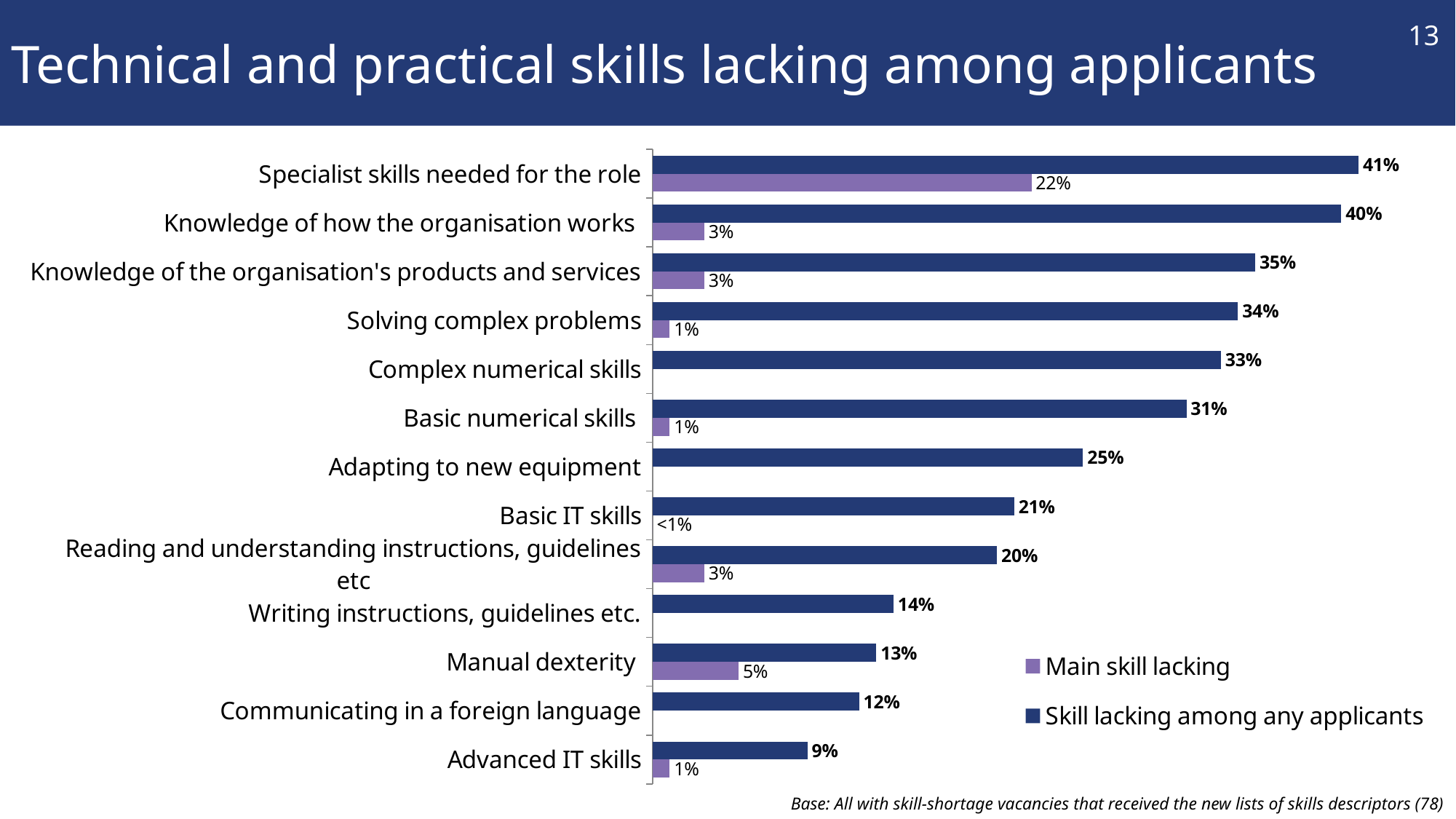
Which category has the highest 'Skill lacking among any applicants' value? Specialist skills needed for the role What is the 'Skill lacking among any applicants' value for Adapting to new equipment? 25% How many series does the legend list? 2 What is the difference between the 'Skill lacking among any applicants' values for Knowledge of how the organisation works and Solving complex problems? 6% What kind of chart is shown on the slide? bar chart Which colour represents the 'Main skill lacking' series in the legend? purple Which has a larger 'Skill lacking among any applicants' value: Basic IT skills or Writing instructions, guidelines etc.? Basic IT skills How many skill categories are shown on the chart? 13 What is the value for 'Skill lacking among any applicants' for Specialist skills needed for the role? 41% Which category has the lowest 'Skill lacking among any applicants' value? Advanced IT skills What is the 'Main skill lacking' value for Specialist skills needed for the role? 22% What is the 'Main skill lacking' value for Manual dexterity? 5%